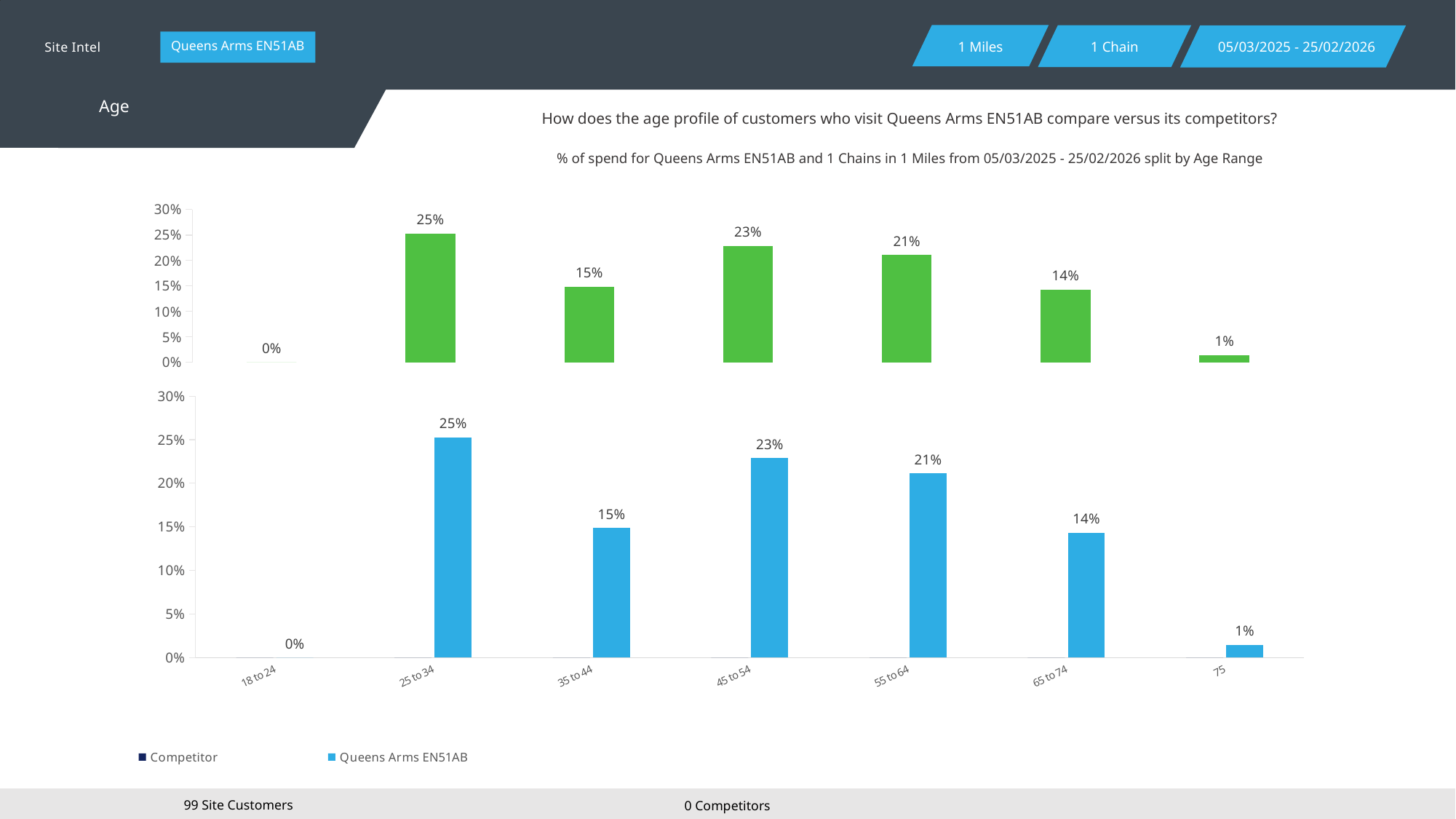
In the bottom chart, which age range has the lowest value? 18 to 24 How many series does the legend list? 2 In the bottom chart, what is the value for the 25 to 34 age range? 25% In the bottom chart, which is larger, the value for 45 to 54 or the value for 55 to 64? 45 to 54 In the top chart, what is the highest value shown on a data label? 25% In the bottom chart, what is the difference between the values for 25 to 34 and 35 to 44? 10% In the bottom chart, is the value for 35 to 44 greater or less than 20%? less What kind of chart is the top chart? bar chart In the bottom chart, what is the value for the 45 to 54 age range? 23% In the bottom chart, what is the value for the 65 to 74 age range? 14% In the bottom chart, which age range has the highest value? 25 to 34 How many age range categories are shown on the x axis of the bottom chart? 7